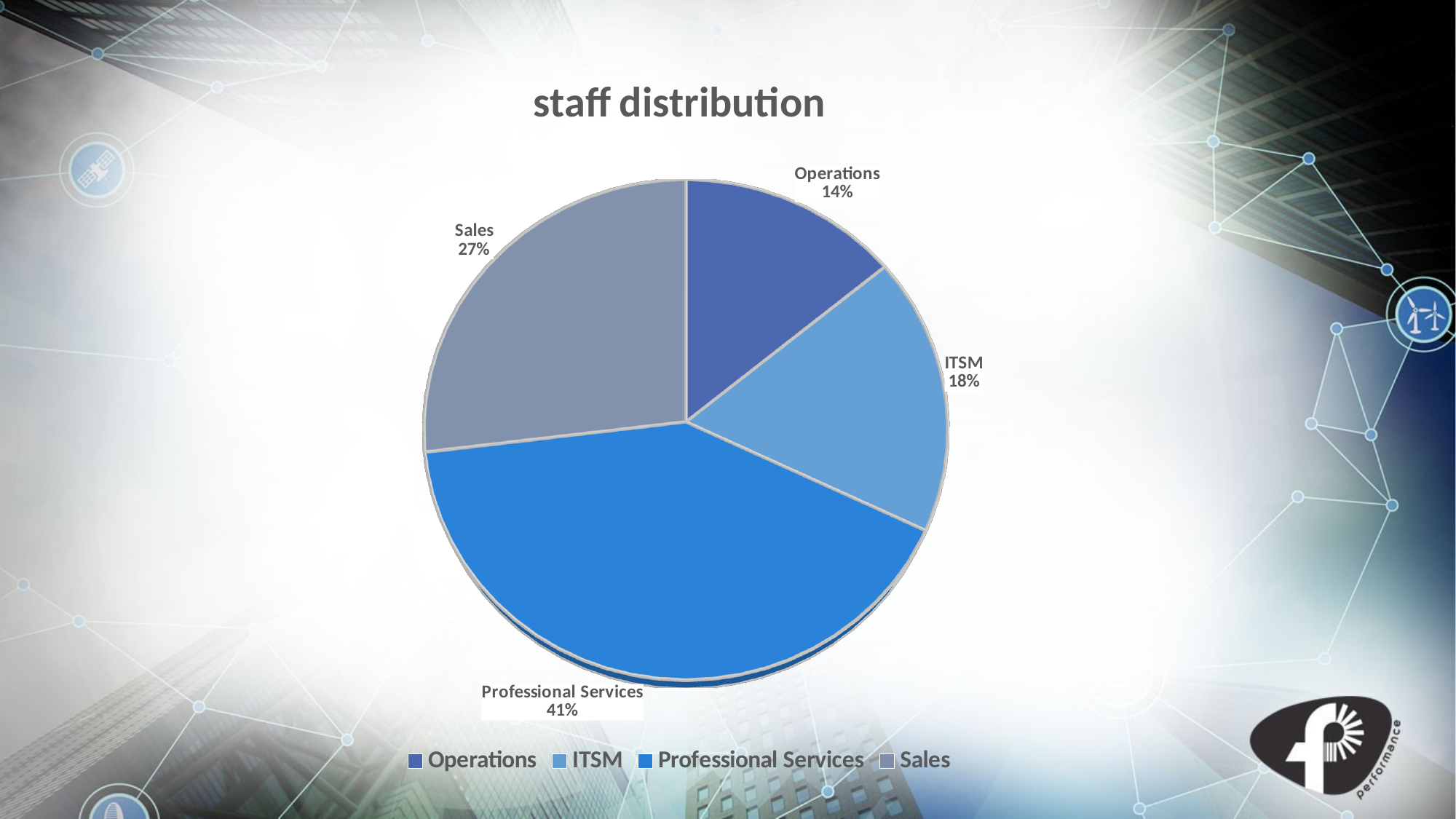
How many entries does the legend list? 4 What share of staff is in Operations? 14% What share of staff is in Sales? 27% What kind of chart is shown on the slide? pie chart Which category has the smallest share of staff? Operations What share of staff is in ITSM? 18% Which is larger, the share for Sales or the share for ITSM? Sales What is the difference in percentage points between the Sales and ITSM shares? 9 How many categories does the pie chart show? 4 Which category has the largest share of staff? Professional Services What share of staff is in Professional Services? 41% What is the title of the chart? staff distribution